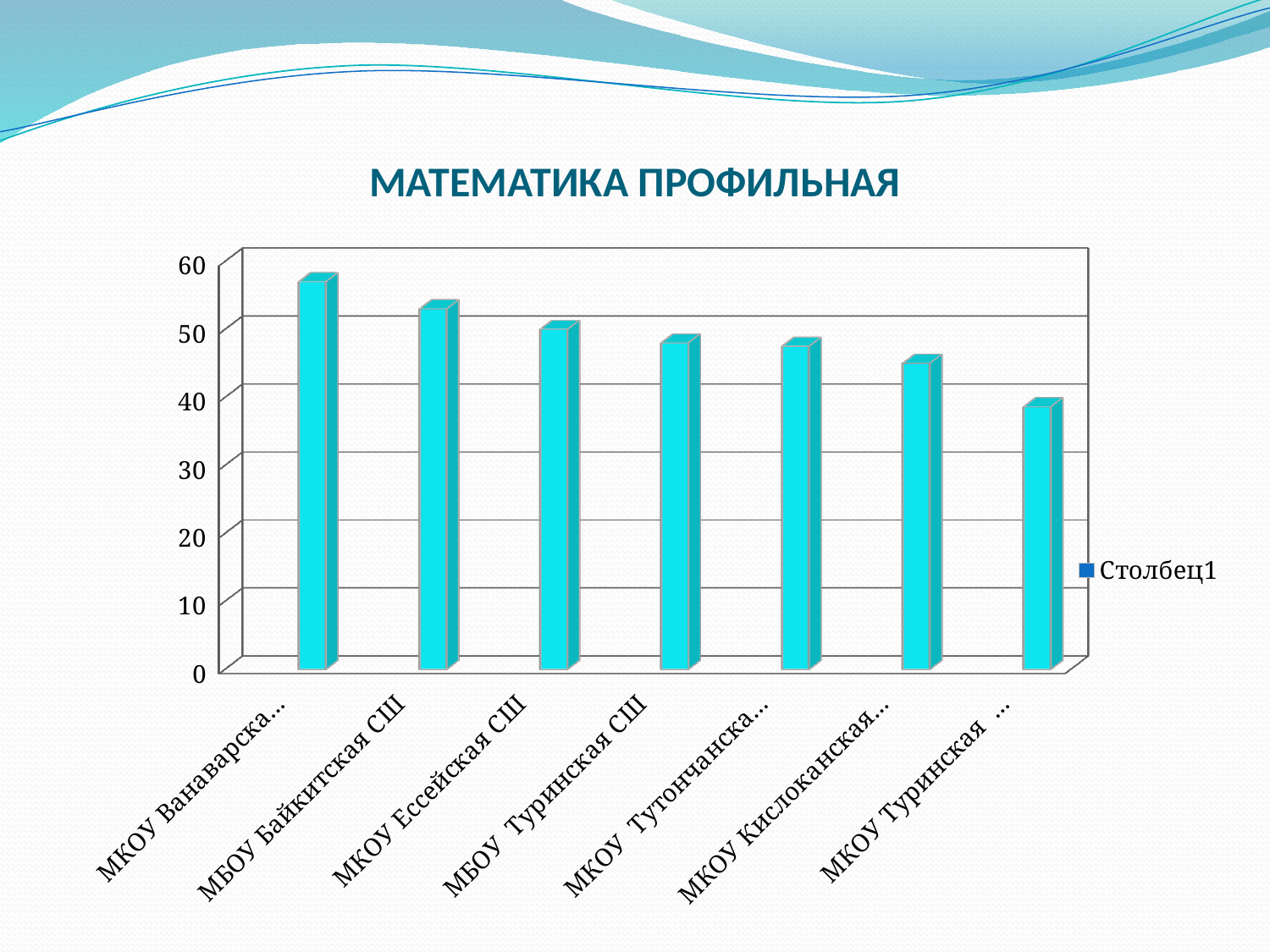
Which category has the highest bar? МКОУ Ванаварска... Is the value for МКОУ Туринская ... greater or less than 50? less Which category has the lowest bar? МКОУ Туринская ... Do the bar values rise or fall from left to right along the x axis? fall How many bars (categories) are plotted in the chart? 7 How many series does the legend list? 1 Is the value for МКОУ Ванаварска... greater or less than 50? greater What kind of chart is shown on the slide? bar chart Is the value for МКОУ Кислоканская... greater or less than 50? less What is the title of the chart? МАТЕМАТИКА ПРОФИЛЬНАЯ Which is larger, the value for МБОУ Байкитская СШ or the value for МКОУ Кислоканская...? МБОУ Байкитская СШ What is the name of the series shown in the legend? Столбец1